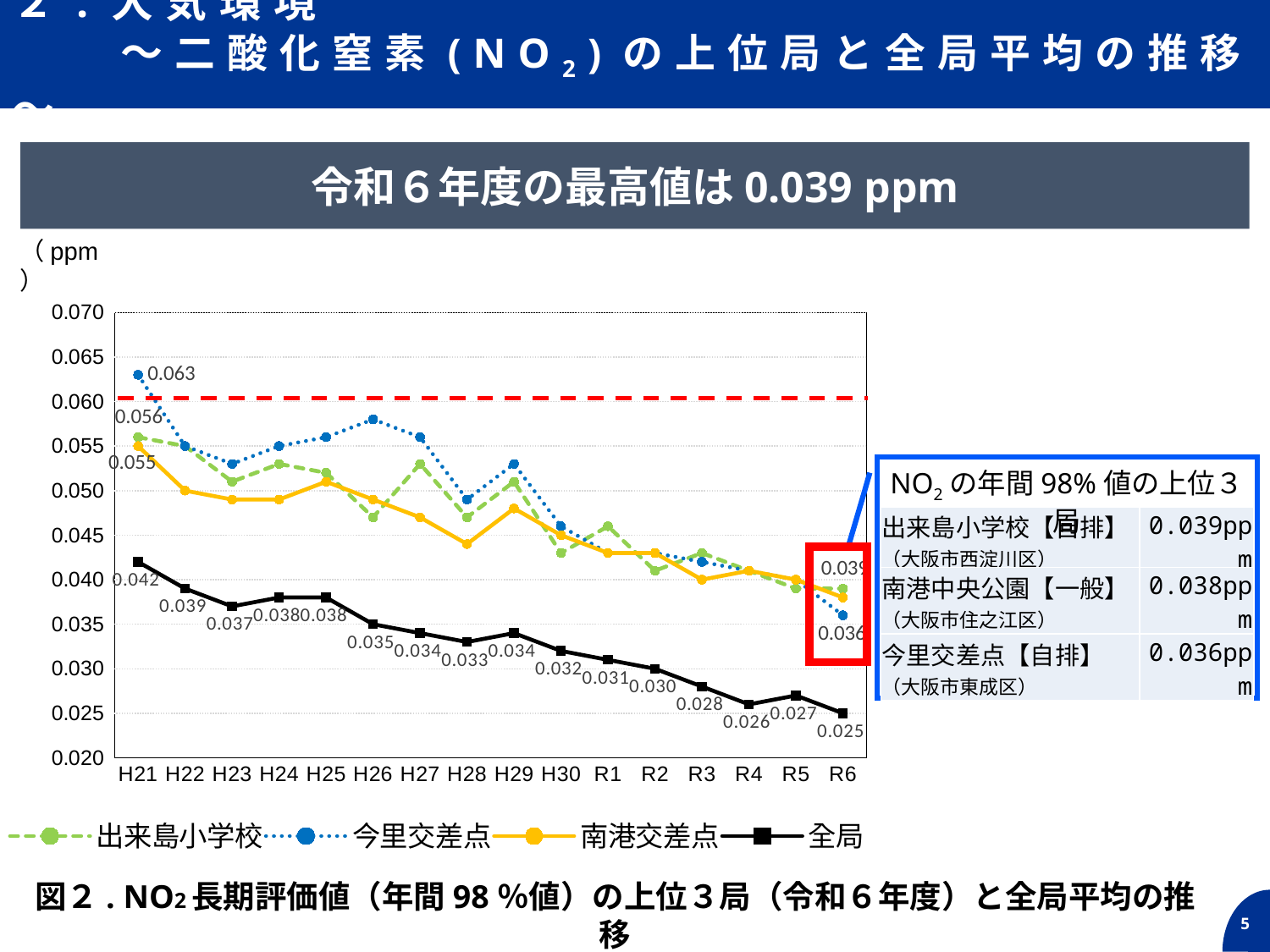
What is the value of 今里交差点 in H21? 0.063 Which series has the highest value in H21? 今里交差点 Is the value for 今里交差点 in H21 greater or less than 0.060? greater Does the 全局 series generally rise or fall from H21 to R6? fall What is the value of 今里交差点 in R6? 0.036 What is the value of 全局 in H21? 0.042 How many years (x-axis categories) are plotted, from H21 to R6? 16 What kind of chart is shown on the slide? line chart How many series does the legend list? 4 What is the value of 全局 in R6? 0.025 By how much did the 全局 value decrease from H21 to R6? 0.017 What is the value of 出来島小学校 in R6? 0.039